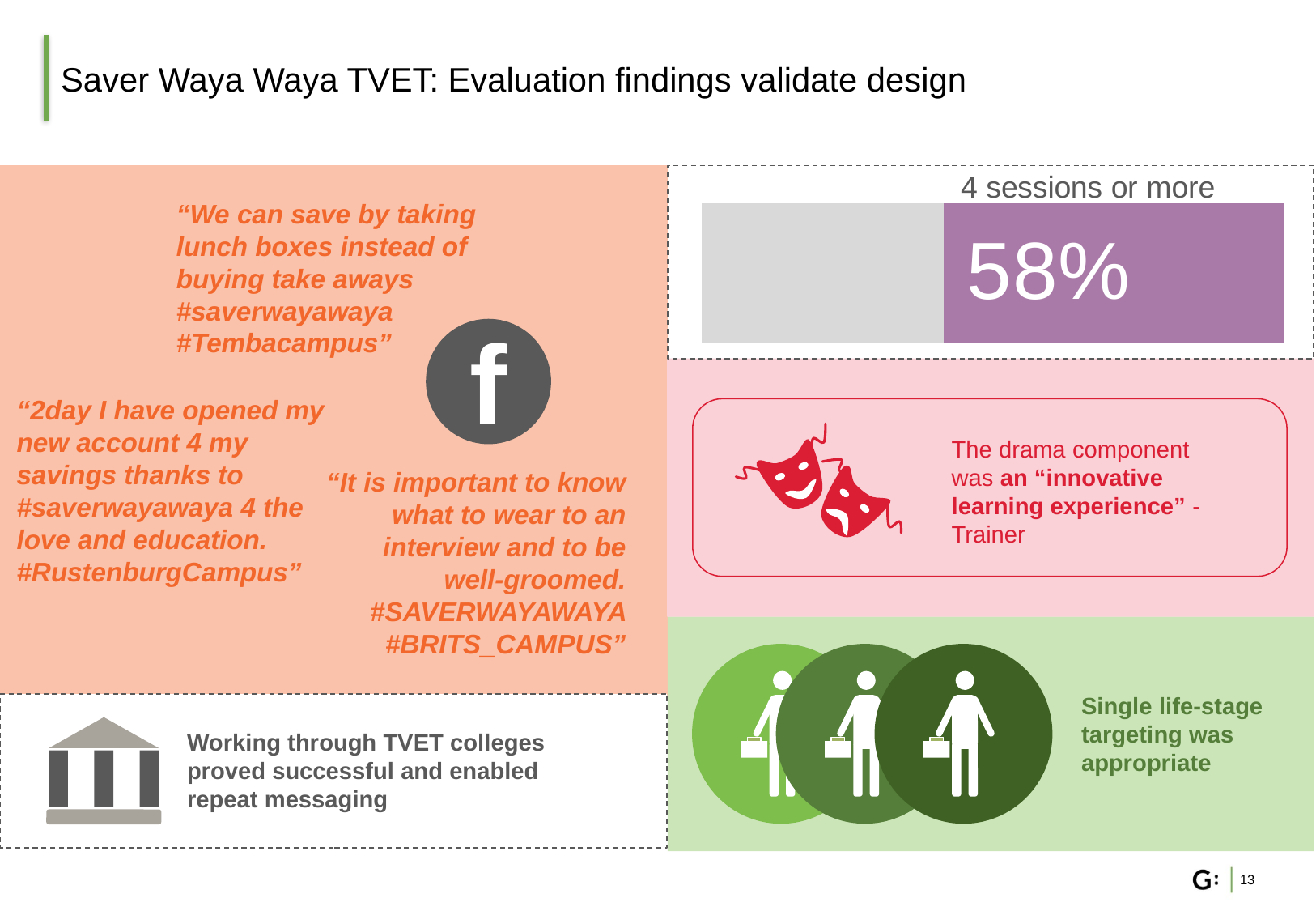
What label appears above the bar chart at the top right of the slide? 4 sessions or more What colour is the filled segment of the bar showing 58%? purple What kind of chart is used to show the "4 sessions or more" figure? bar chart How many categories are shown in the bar chart at the top right of the slide? 1 What percentage is shown in the bar chart for "4 sessions or more"? 58%